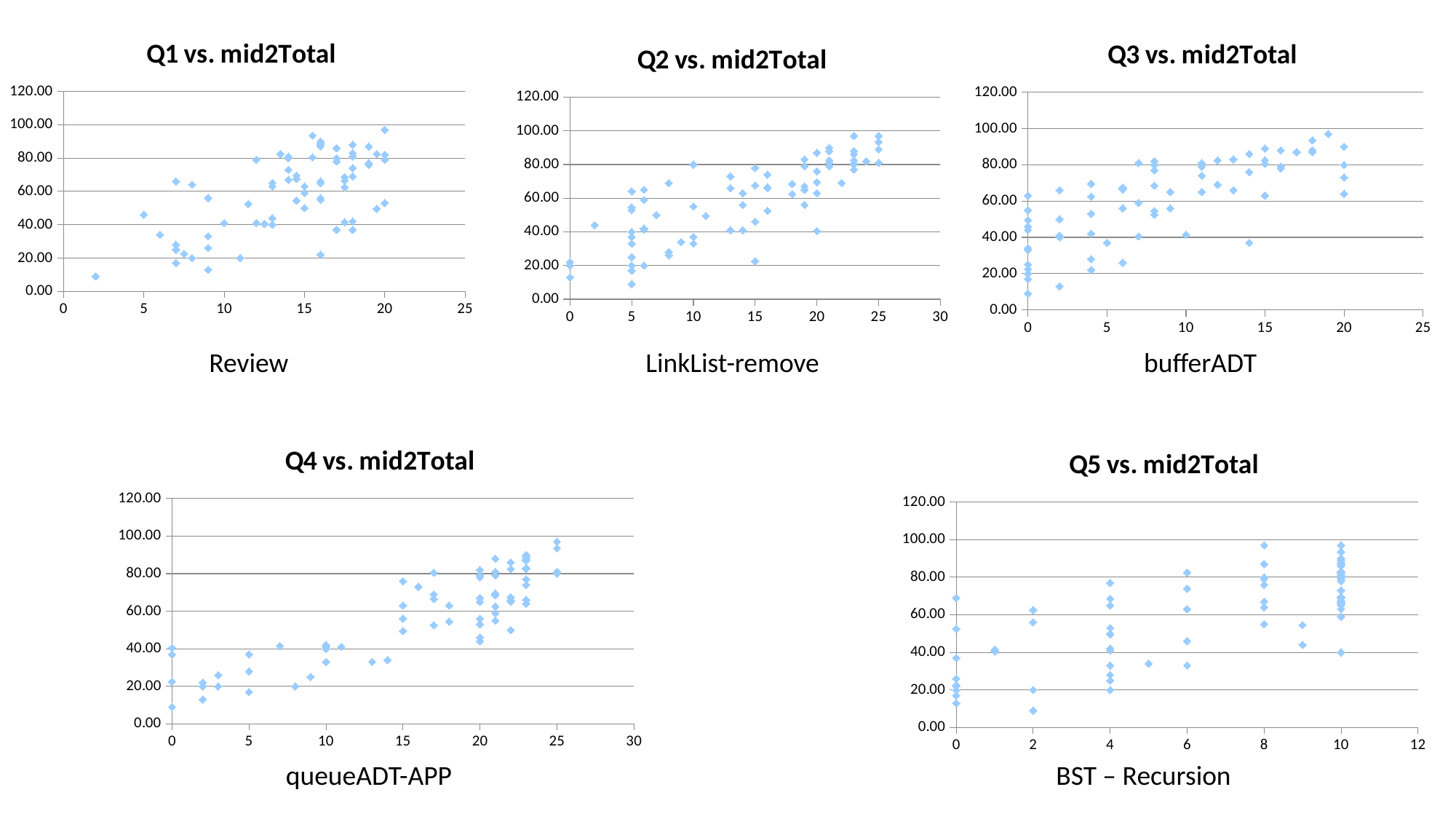
In the "Q5 vs. mid2Total" chart, is the y value of the point at x = 1 greater or less than 60? less In the "Q1 vs. mid2Total" chart, do the y values generally rise or fall as the x value increases? rise In the "Q2 vs. mid2Total" chart, is the y value of the point at x = 2 greater or less than 60? less In the "Q4 vs. mid2Total" chart, is the y value of the point at x = 8 greater or less than 40? less What kind of chart is "Q1 vs. mid2Total"? scatter chart What caption appears below the "Q3 vs. mid2Total" chart? bufferADT In the "Q4 vs. mid2Total" chart, do the y values generally rise or fall as the x value increases? rise In the "Q5 vs. mid2Total" chart, do the y values generally rise or fall as the x value increases? rise How many charts are shown on the slide? 5 What caption appears below the "Q5 vs. mid2Total" chart? BST – Recursion